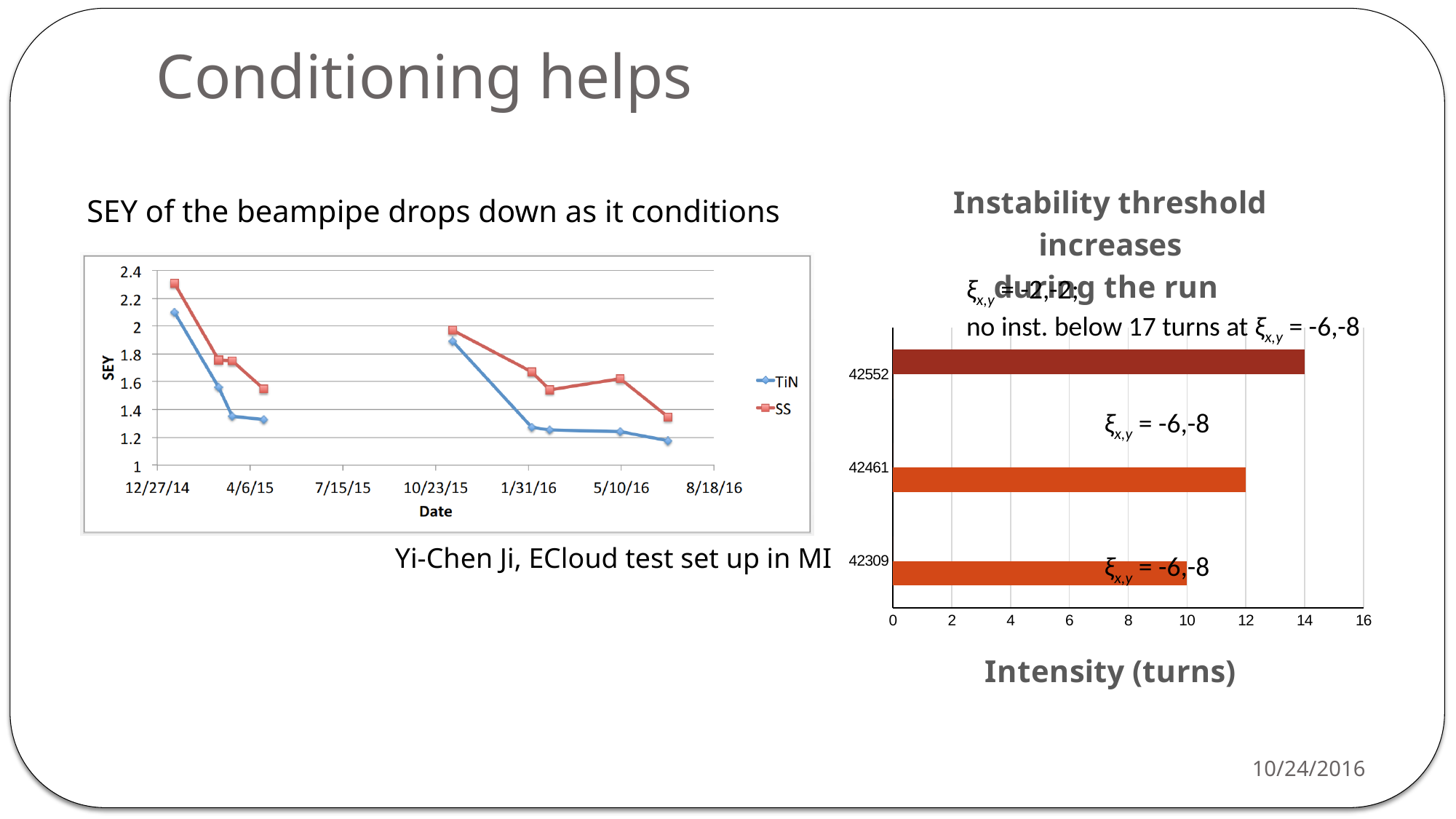
In the 'Instability threshold increases during the run' chart, which category has the lowest value? 42309 In the 'Instability threshold increases during the run' chart, what is the value for 42552? 14 In the 'Instability threshold increases during the run' chart, what is the difference between the values for 42552 and 42309? 4 In the SEY vs Date chart on the left, how many series does the legend list? 2 In the 'Instability threshold increases during the run' chart, what is the value for 42309? 10 What kind of chart is the 'Instability threshold increases during the run' chart? bar chart In the 'Instability threshold increases during the run' chart, which category has the highest value? 42552 In the SEY vs Date chart on the left, do the TiN values generally rise or fall over time? fall In the 'Instability threshold increases during the run' chart, what is the x-axis title? Intensity (turns) In the SEY vs Date chart on the left, is the first SS value greater or less than 2.2? greater In the 'Instability threshold increases during the run' chart, what is the value for 42461? 12 In the 'Instability threshold increases during the run' chart, how many bars are there? 3